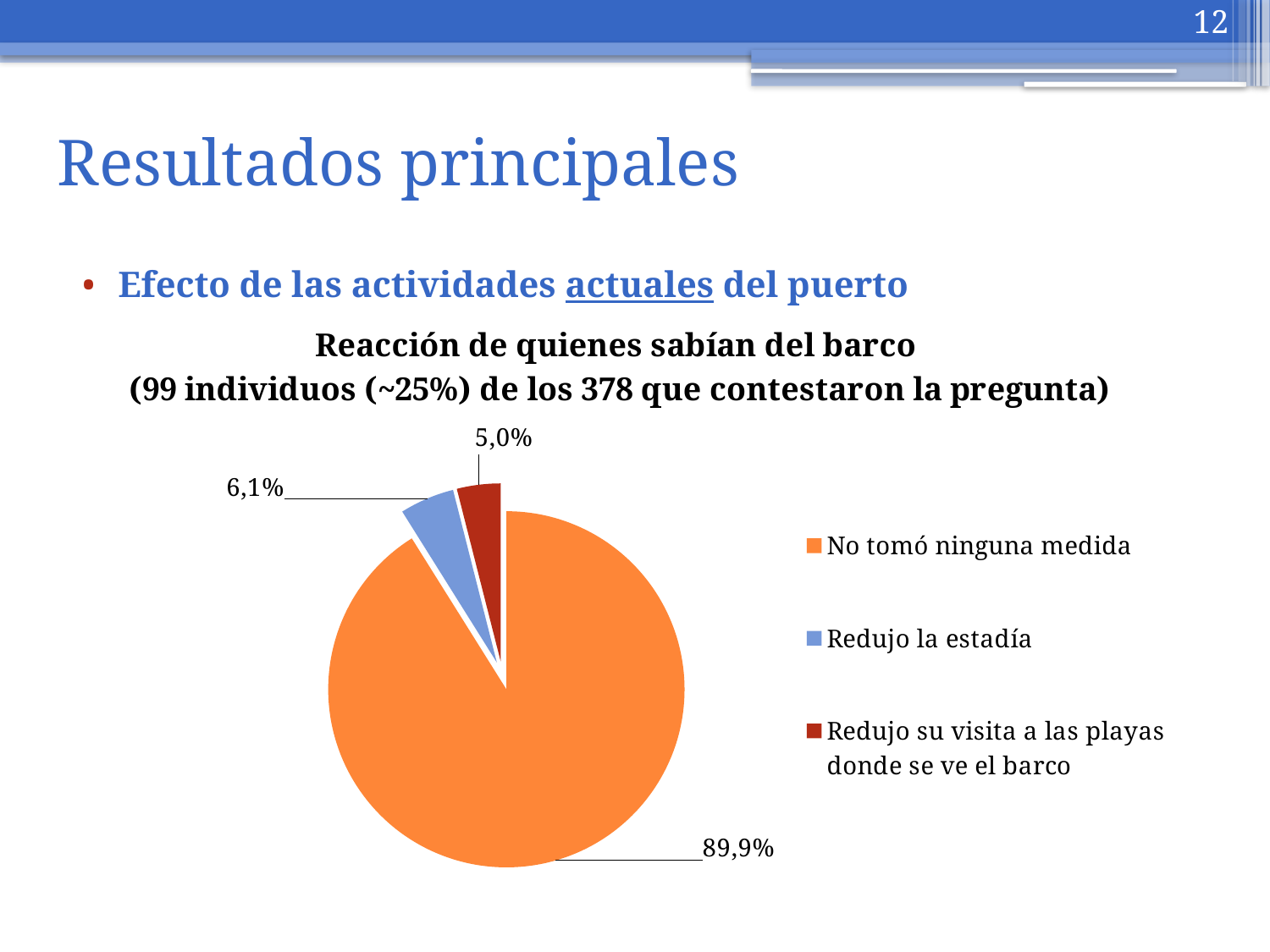
What kind of chart is shown on the slide? Pie chart Which is larger: the slice for "Redujo la estadía" or the slice for "Redujo su visita a las playas donde se ve el barco"? Redujo la estadía What is the difference in percentage points between "No tomó ninguna medida" and "Redujo la estadía"? 83,8 How many entries does the legend list? 3 Which category has the largest slice of the pie? No tomó ninguna medida What share of the pie does "Redujo la estadía" represent? 6,1% Which category has the smallest slice of the pie? Redujo su visita a las playas donde se ve el barco What share of the pie does "Redujo su visita a las playas donde se ve el barco" represent? 5,0% According to the chart title, how many individuals knew about the ship? 99 What colour is the slice for "No tomó ninguna medida"? Orange What share of the pie does "No tomó ninguna medida" represent? 89,9% How many slices does the pie chart have? 3